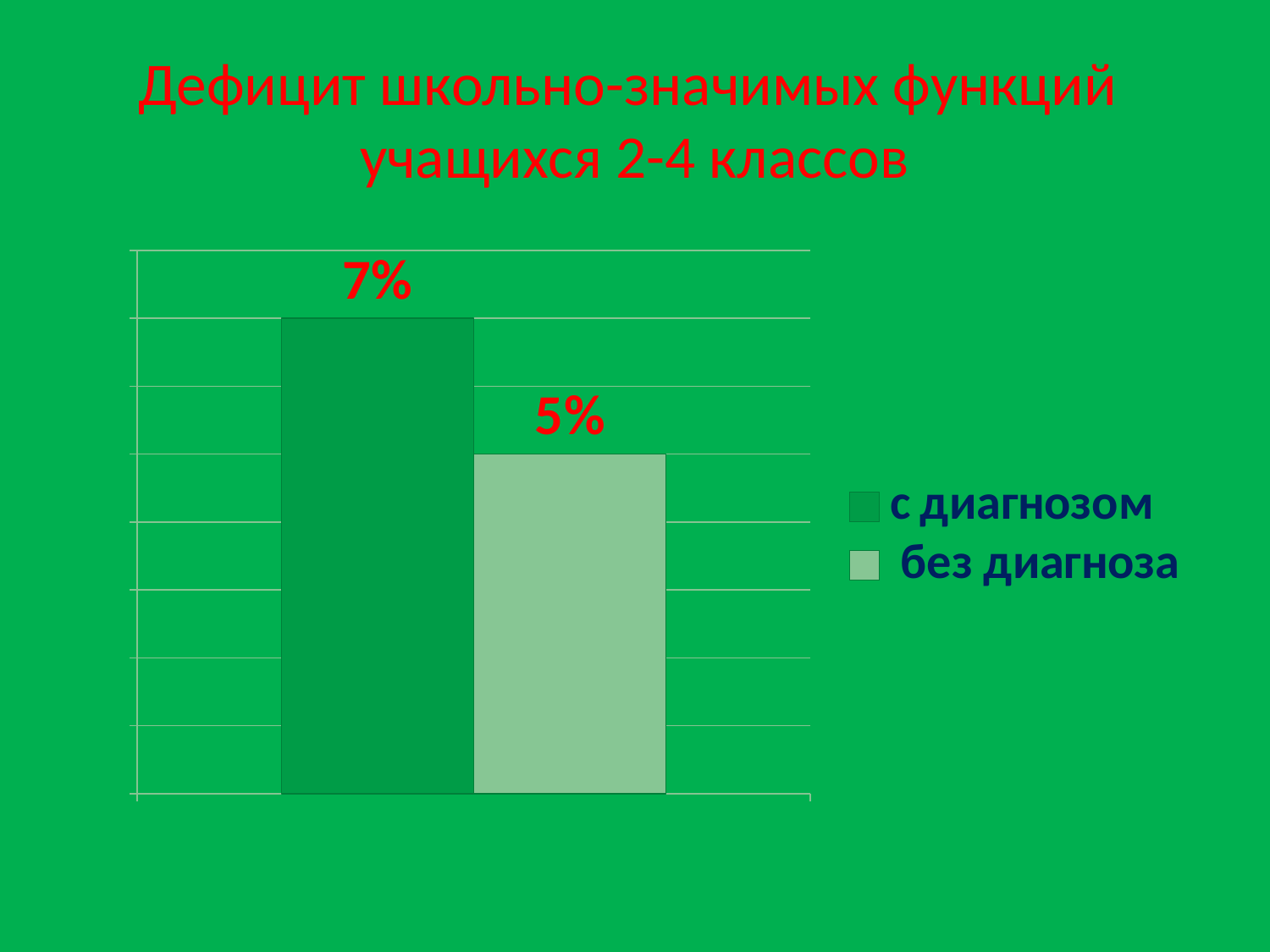
What is the title of the slide? Дефицит школьно-значимых функций учащихся 2-4 классов Which series has the lowest value? без диагноза How many series does the legend list? 2 What is the difference between the values for "с диагнозом" and "без диагноза"? 2% What is the value for "с диагнозом"? 7% Which legend entry is shown in the darker green colour? с диагнозом What kind of chart is shown on the slide? bar chart What is the value for "без диагноза"? 5% Which is larger, the value for "с диагнозом" or for "без диагноза"? с диагнозом Which series has the highest value? с диагнозом How many bars are plotted on the chart? 2